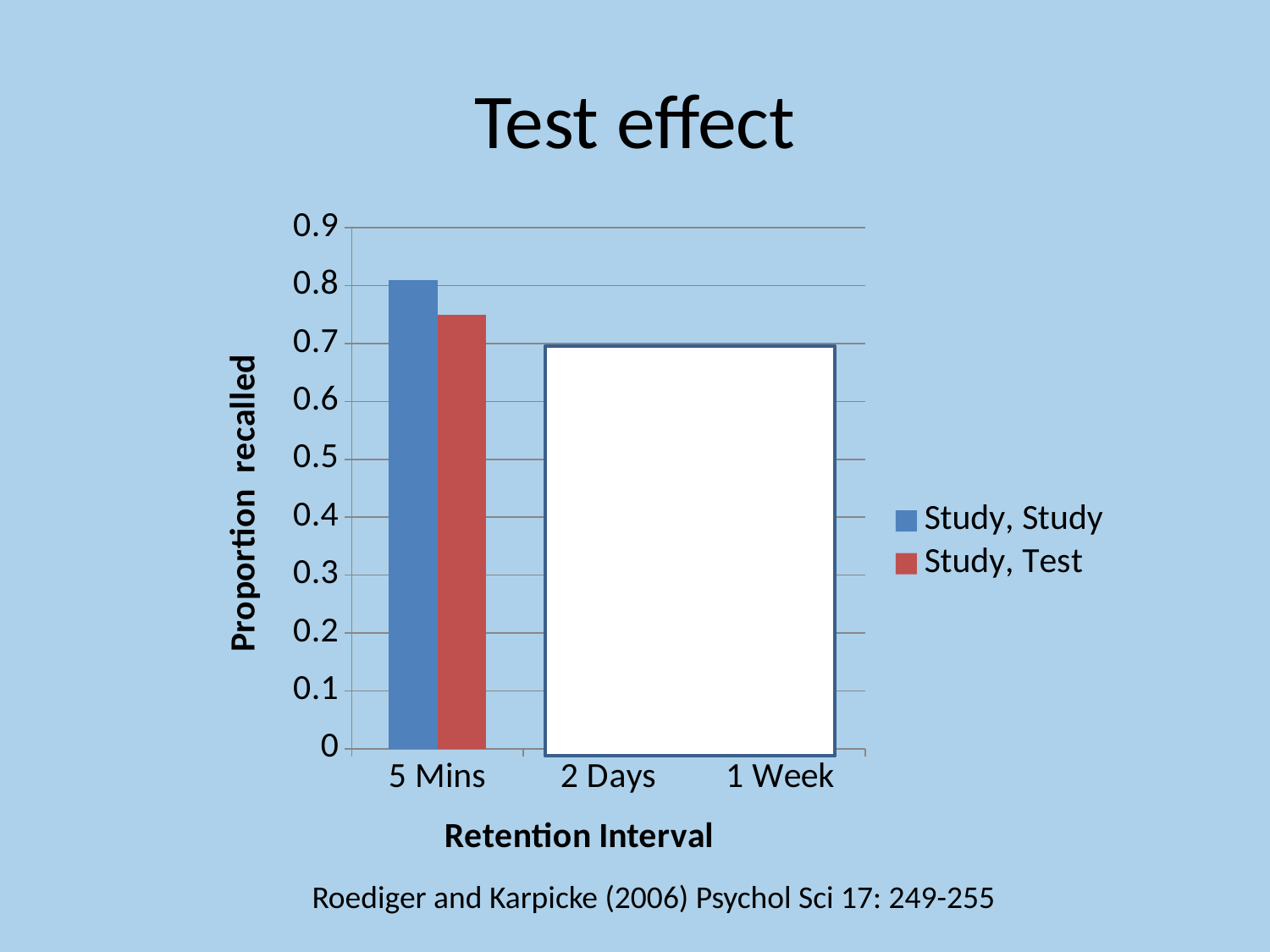
Is the Study, Study value at 5 Mins greater or less than 0.7? greater Is the Study, Test value at 5 Mins greater or less than 0.7? greater Is the Study, Study value at 5 Mins greater or less than 0.5? greater What is the title of the y axis? Proportion recalled How many series does the legend list? 2 How many retention interval categories are labelled on the x axis? 3 What kind of chart is shown on the slide? bar chart Which colour represents the Study, Test series in the legend? red At the 5 Mins retention interval, which series has the higher proportion recalled, Study, Study or Study, Test? Study, Study